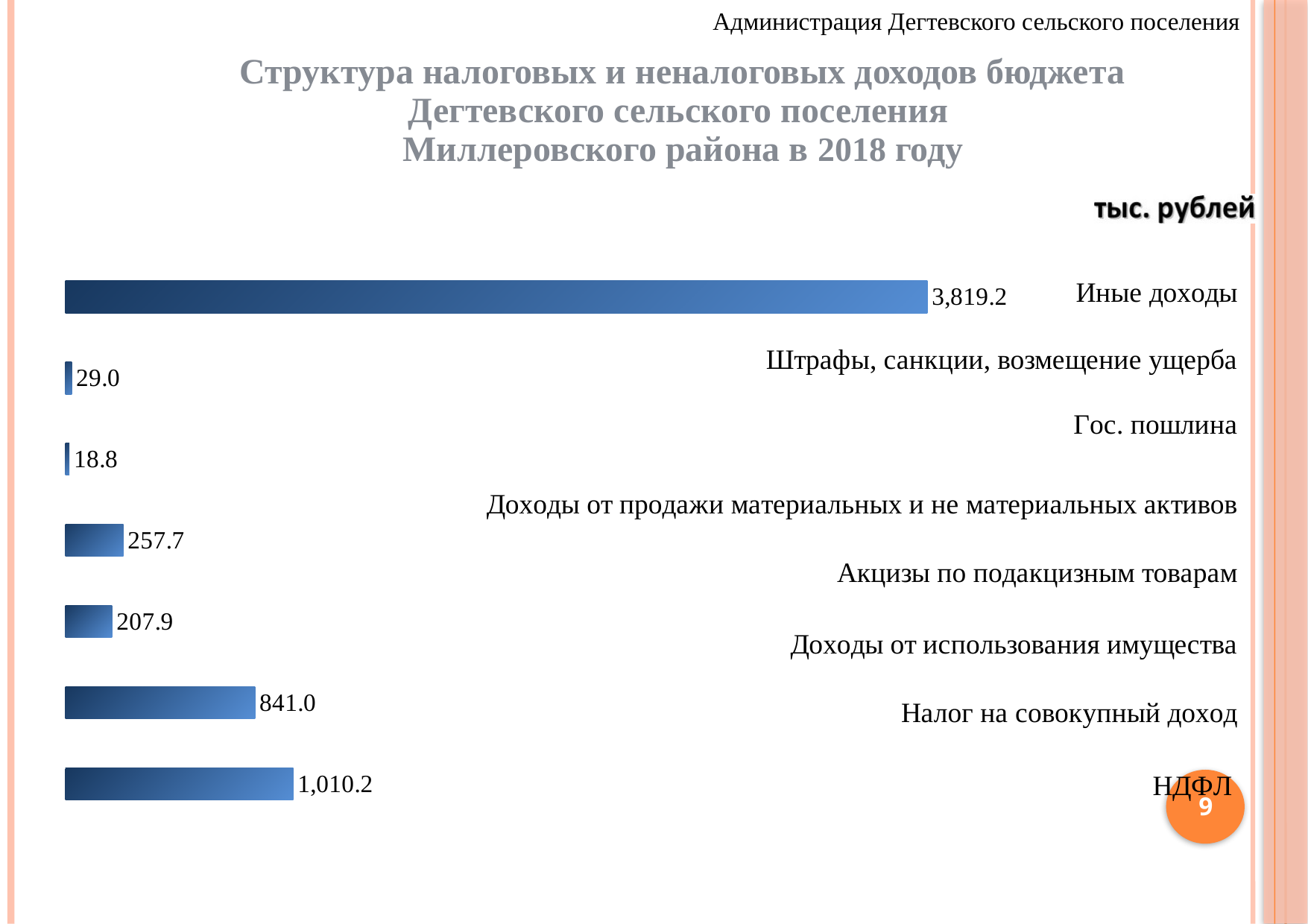
Which category has the highest value? Иные доходы What type of chart is shown on the slide? bar chart In what units are the values on the chart given? тыс. рублей Which is larger, the value for НДФЛ or the value for Налог на совокупный доход? НДФЛ What is the difference between the values for НДФЛ and Налог на совокупный доход? 169.2 What is the value for Иные доходы? 3,819.2 What is the value for Штрафы, санкции, возмещение ущерба? 29.0 What is the value for Налог на совокупный доход? 841.0 Which category has the lowest value? Гос. пошлина What is the value for НДФЛ? 1,010.2 What is the difference between the values for Иные доходы and НДФЛ? 2,809.0 What is the value for Гос. пошлина? 18.8